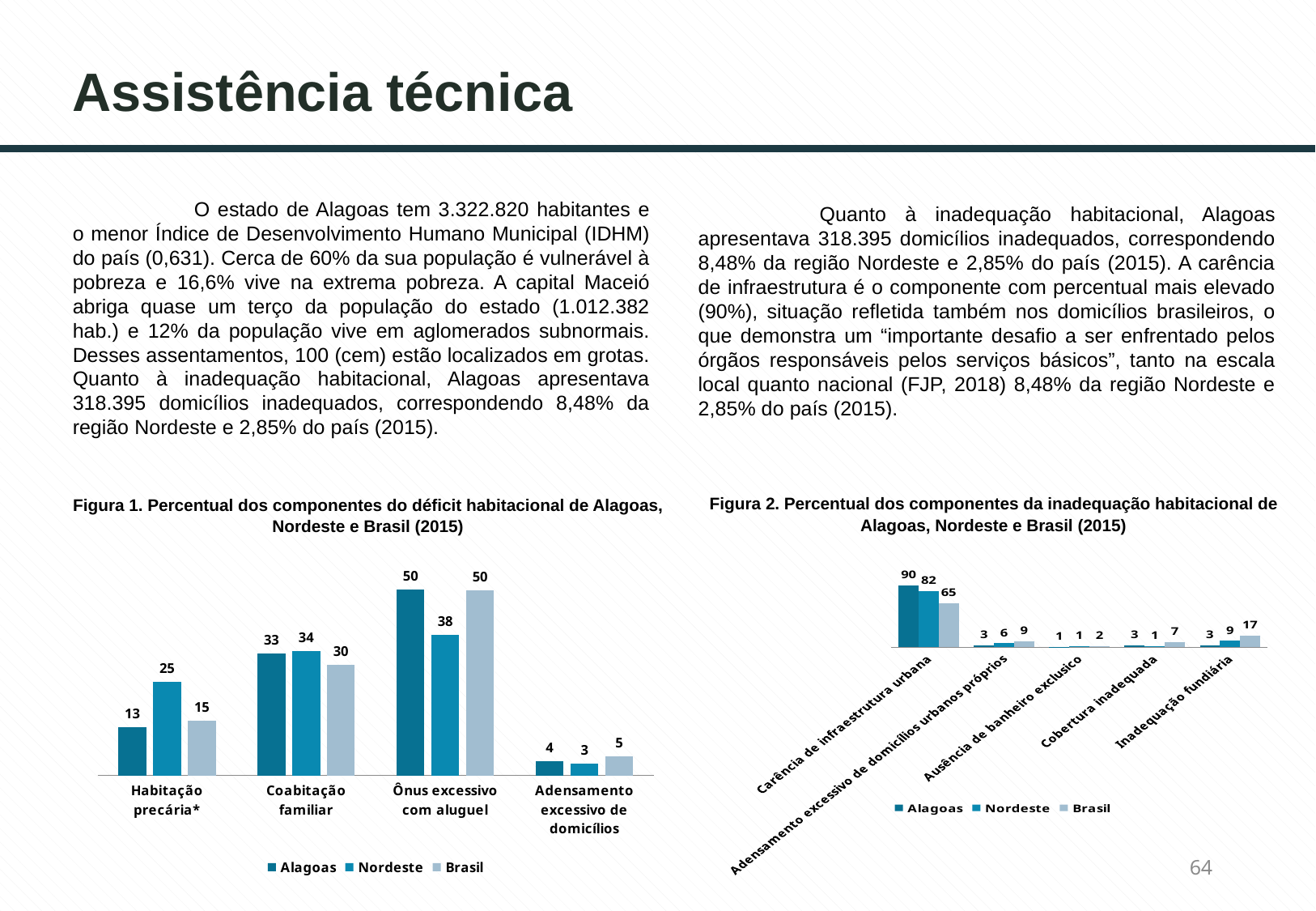
In Figura 1, which category has the highest value for Alagoas? Ônus excessivo com aluguel In Figura 2, what is the value for Brasil in the Inadequação fundiária category? 17 In Figura 1, what is the value for Nordeste in the Habitação precária* category? 25 In Figura 1, what is the difference between the Alagoas and Nordeste values for Ônus excessivo com aluguel? 12 In Figura 1, how many series does the legend list? 3 In Figura 2, which is larger for Cobertura inadequada: the Brasil value or the Nordeste value? Brasil In Figura 1, which category has the lowest value for Nordeste? Adensamento excessivo de domicílios In Figura 1, how many categories are shown on the x axis? 4 What kind of chart is Figura 2? Bar chart In Figura 1, what is the value for Brasil in the Coabitação familiar category? 30 In Figura 2, what is the value for Alagoas in the Carência de infraestrutura urbana category? 90 In Figura 2, what is the difference between the Alagoas and Brasil values for Carência de infraestrutura urbana? 25